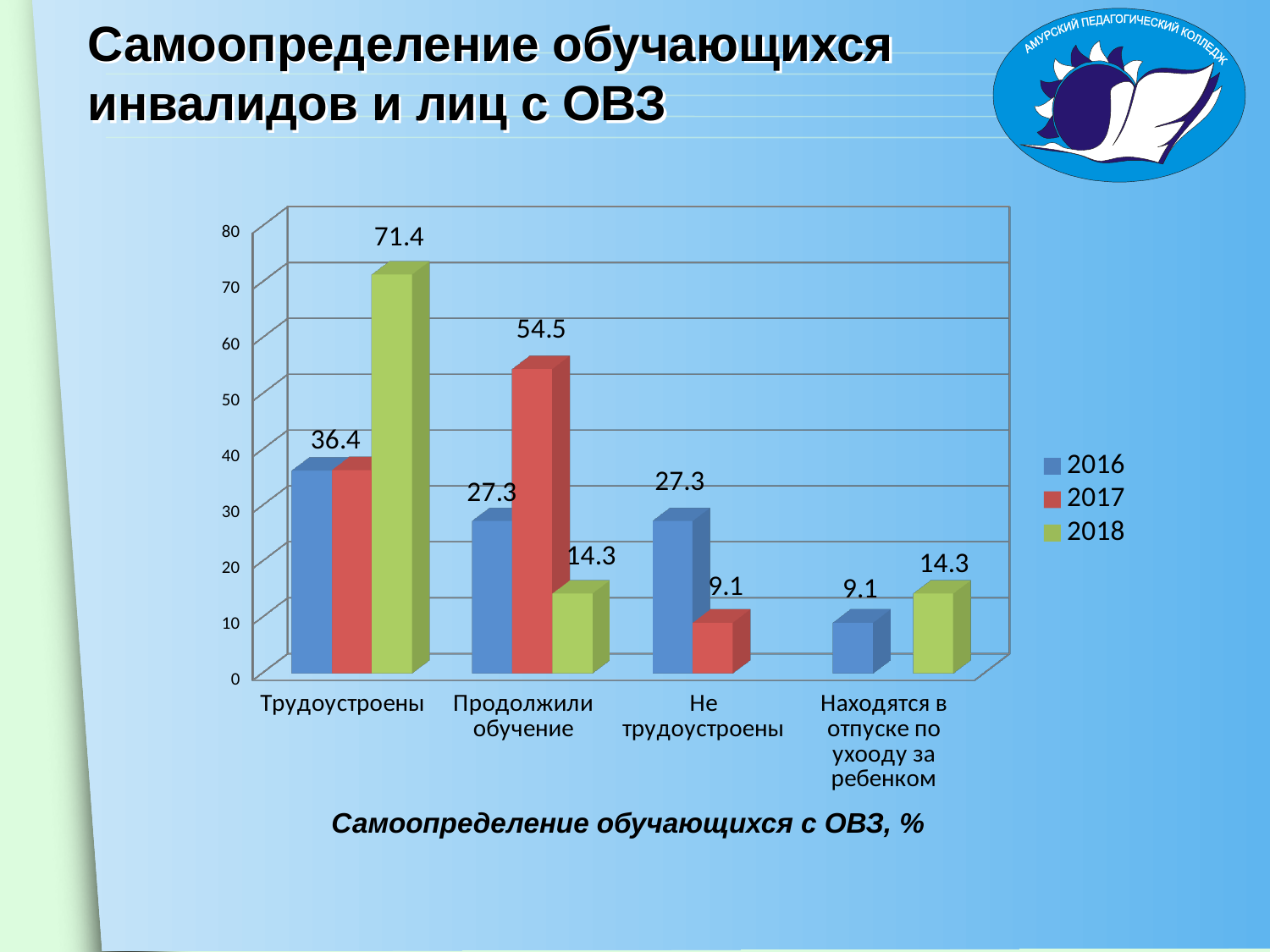
What kind of chart is shown on the slide? bar chart How many series does the legend list? 3 What is the value for 2017 in the Продолжили обучение category? 54.5 How many categories are shown on the x axis? 4 What is the difference between the 2017 and 2018 values in the Продолжили обучение category? 40.2 What is the value for 2018 in the Трудоустроены category? 71.4 Which category has the lowest value for the 2016 series? Находятся в отпуске по уходу за ребенком Is the value for 2017 in the Трудоустроены category greater or less than 30? greater Which category has the highest value for the 2018 series? Трудоустроены In the Не трудоустроены category, which is larger: the 2016 value or the 2017 value? 2016 What is the value for 2016 in the Не трудоустроены category? 27.3 What is the value for 2018 in the Находятся в отпуске по уходу за ребенком category? 14.3